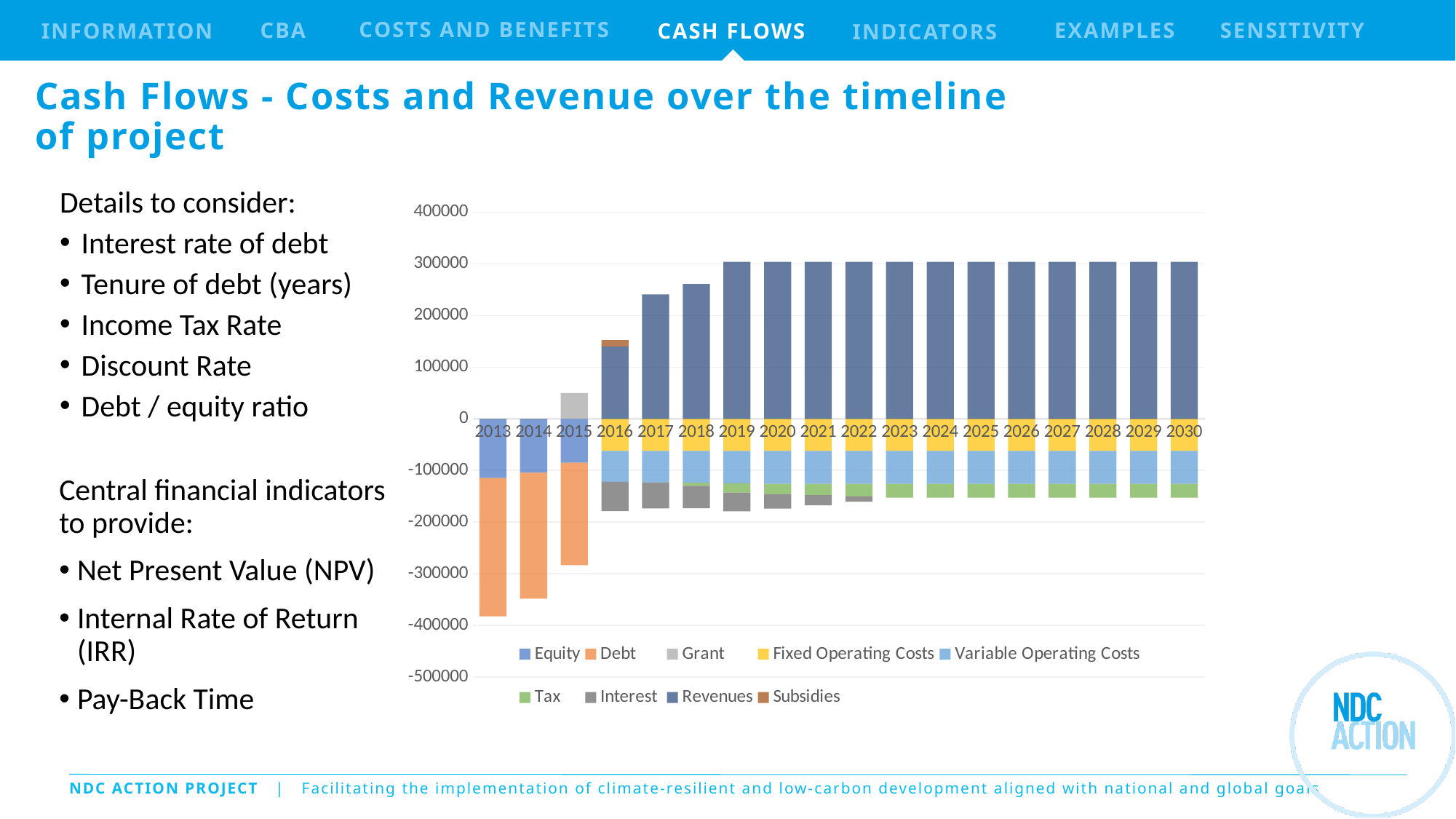
How many series does the chart legend list? 9 Is the value for Revenues in 2016 greater or less than 200000? less Which series in the legend is shown in orange? Debt Is the value for Grant in 2015 greater or less than 100000? less Is the value for Revenues in 2019 greater or less than 200000? greater How many years are shown on the x axis of the chart? 18 In which years does the Grant series appear in the chart? 2015 What kind of chart is shown on the slide? Stacked bar chart Which is larger, the Revenues value for 2017 or for 2019? 2019 Do the Revenues values rise or fall from 2016 to 2019? rise Which year has the most negative (lowest) stacked total in the chart? 2013